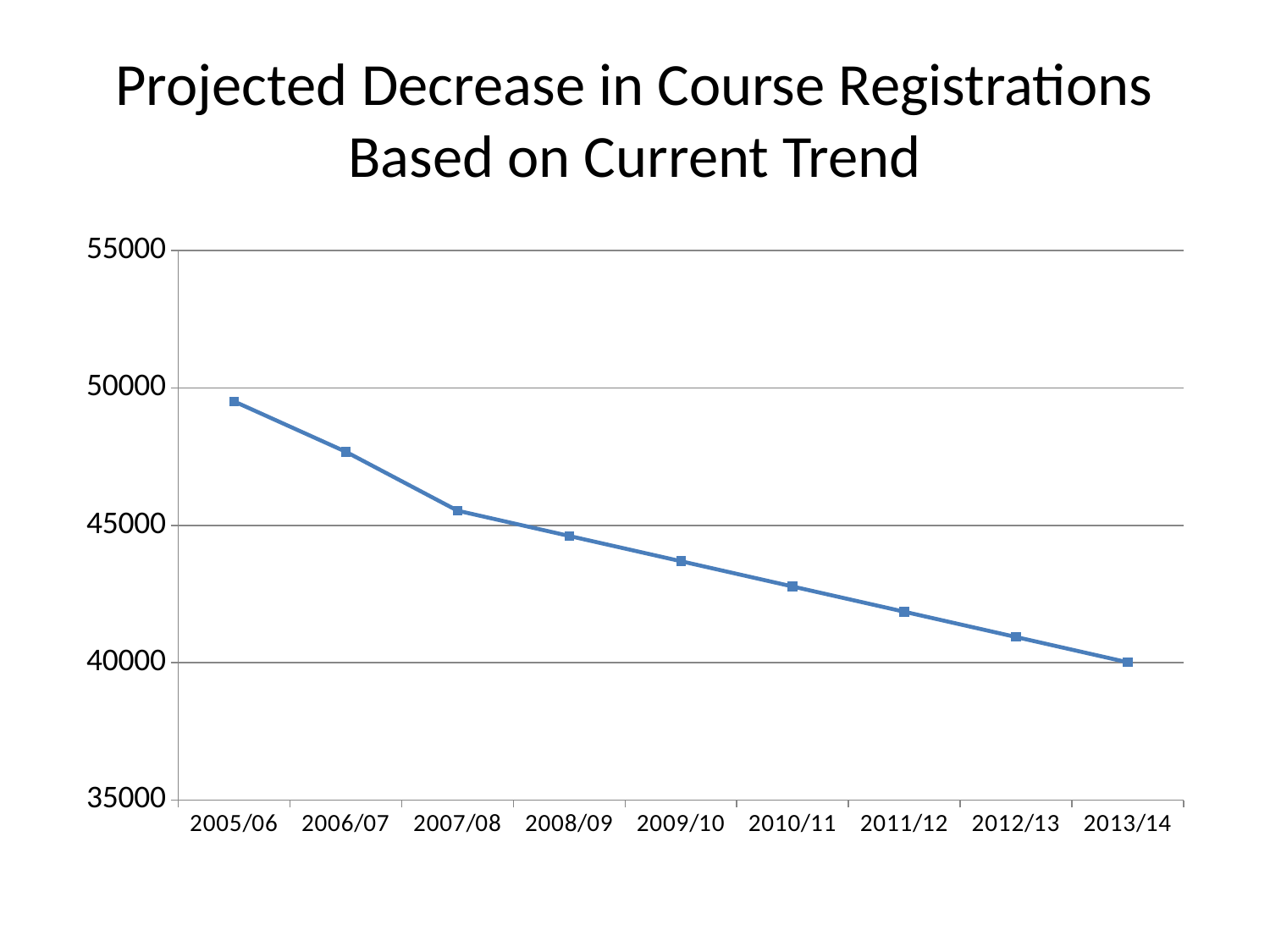
Which year has the lowest value? 2013/14 Do the values rise or fall from 2005/06 to 2013/14? fall Which year has the highest value? 2005/06 What is the title of the chart? Projected Decrease in Course Registrations Based on Current Trend What kind of chart is shown on the slide? line chart Is the value for 2011/12 greater or less than 40000? greater Which is larger, the value for 2006/07 or the value for 2010/11? 2006/07 Is the value for 2009/10 greater or less than 45000? less Is the value for 2005/06 greater or less than 50000? less How many academic years are plotted on the x axis? 9